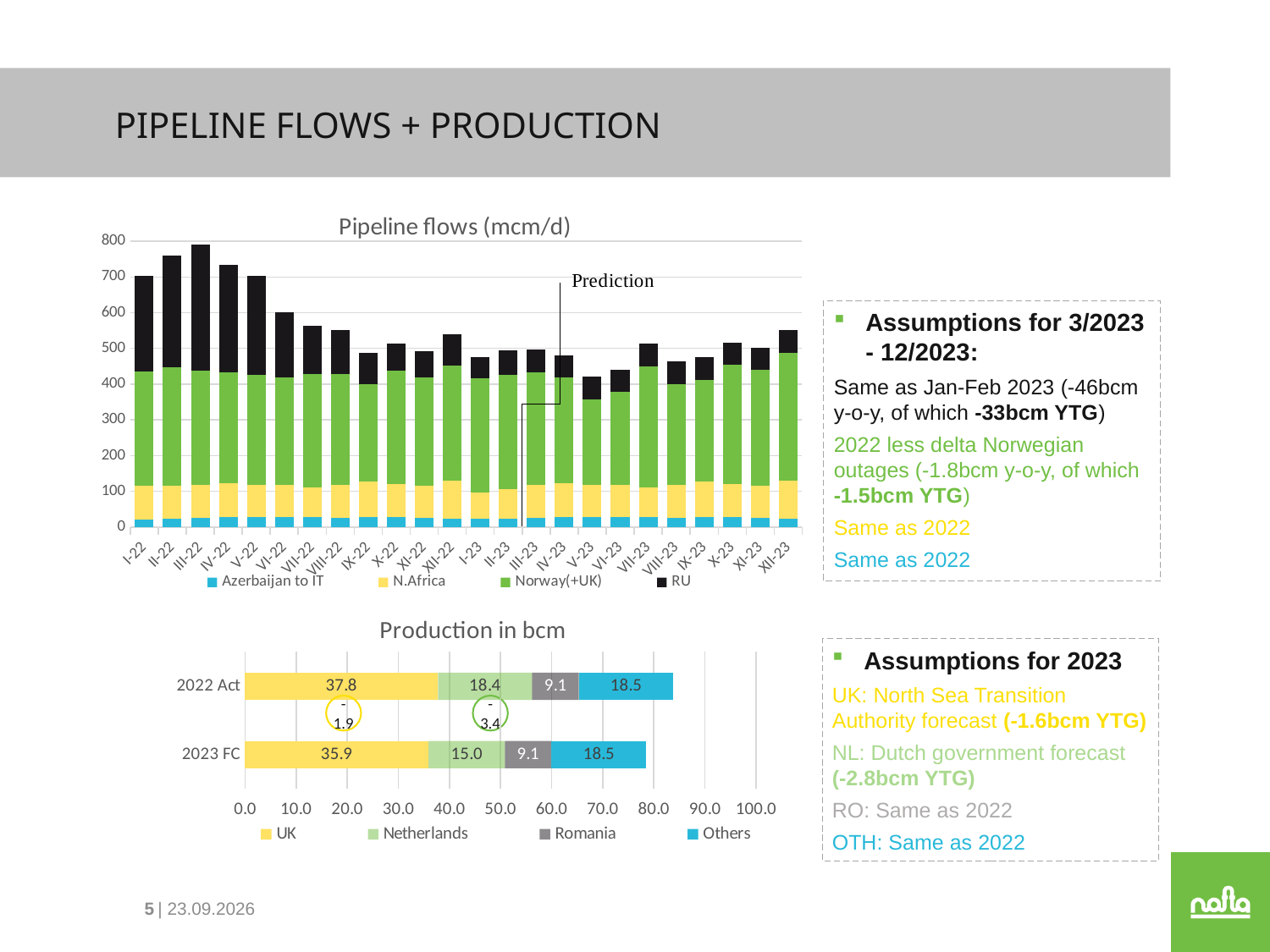
In the Production in bcm chart, what is the Romania value for 2022 Act? 9.1 In the Production in bcm chart, what is the total of the 2023 FC stacked bar? 78.5 In the Production in bcm chart, what is the Others value for 2023 FC? 18.5 In the Production in bcm chart, what is the Netherlands value for 2023 FC? 15.0 In the Pipeline flows (mcm/d) chart, is the total value for V-23 greater or less than 500? less In the Production in bcm chart, what is the UK value for 2022 Act? 37.8 In the Pipeline flows (mcm/d) chart, which month has the highest total bar? III-22 In the Production in bcm chart, what is the difference between the UK values for 2022 Act and 2023 FC? 1.9 How many series does the legend of the Production in bcm chart list? 4 In the Production in bcm chart, what is the total of the 2022 Act stacked bar? 83.8 In the Production in bcm chart, which is larger, the Netherlands value for 2022 Act or for 2023 FC? 2022 Act What kind of chart is the Pipeline flows (mcm/d) chart? Stacked bar chart